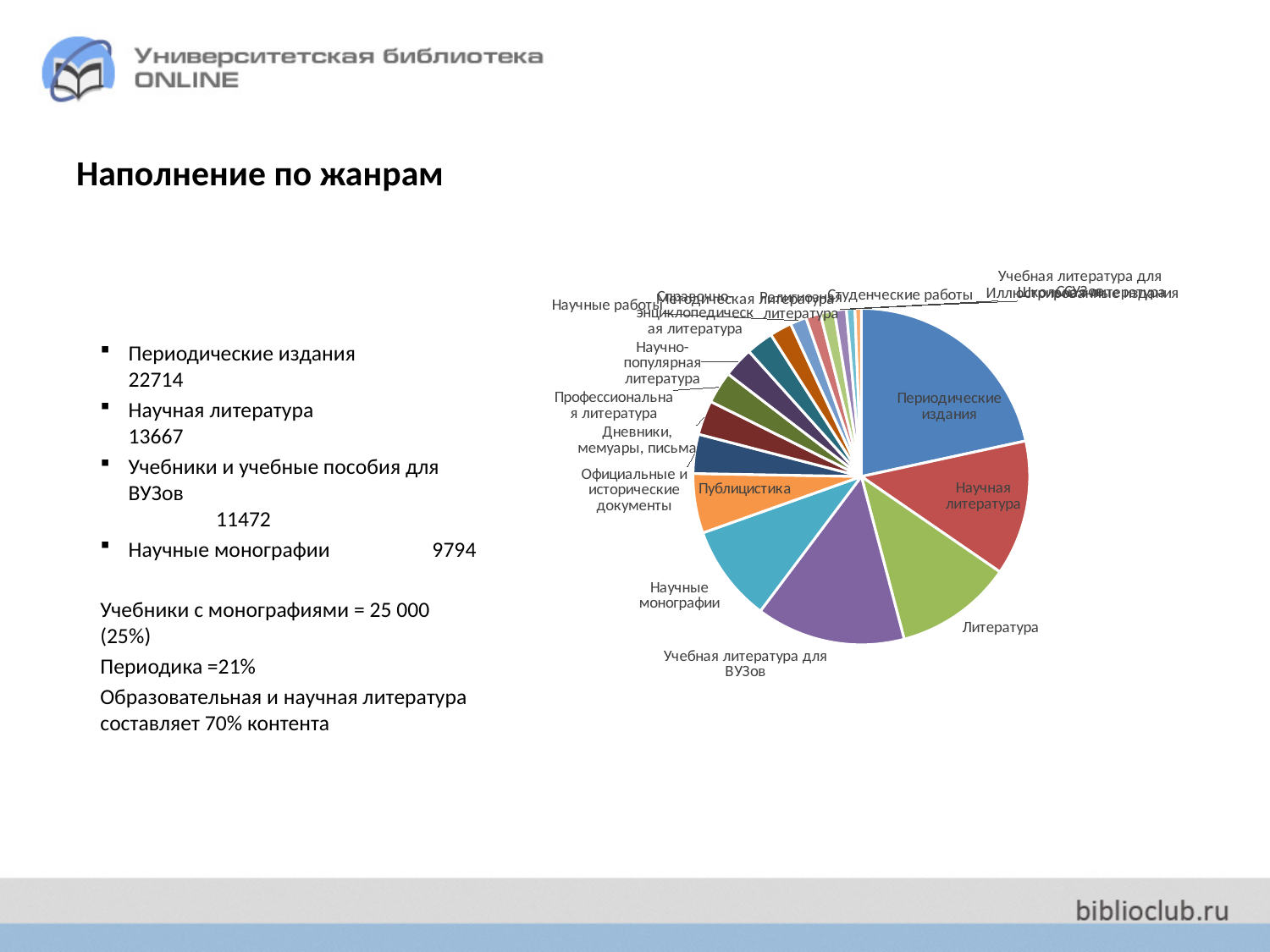
Which slice is larger: Научные монографии or Публицистика? Научные монографии According to the slide, what is the value for Научная литература? 13667 According to the slide, what share of the content is Периодика? 21% Which slice is larger: Периодические издания or Научная литература? Периодические издания What is the title of the slide containing the pie chart? Наполнение по жанрам According to the slide, what is the value for Периодические издания? 22714 According to the slide, what is the value for Научные монографии? 9794 Which category has the largest slice in the pie chart? Периодические издания According to the slide, what share of the content do Учебники с монографиями make up? 25% What is the difference between the values for Периодические издания and Научная литература? 9047 What kind of chart is shown on the slide? pie chart Which slice is larger: Литература or Публицистика? Литература